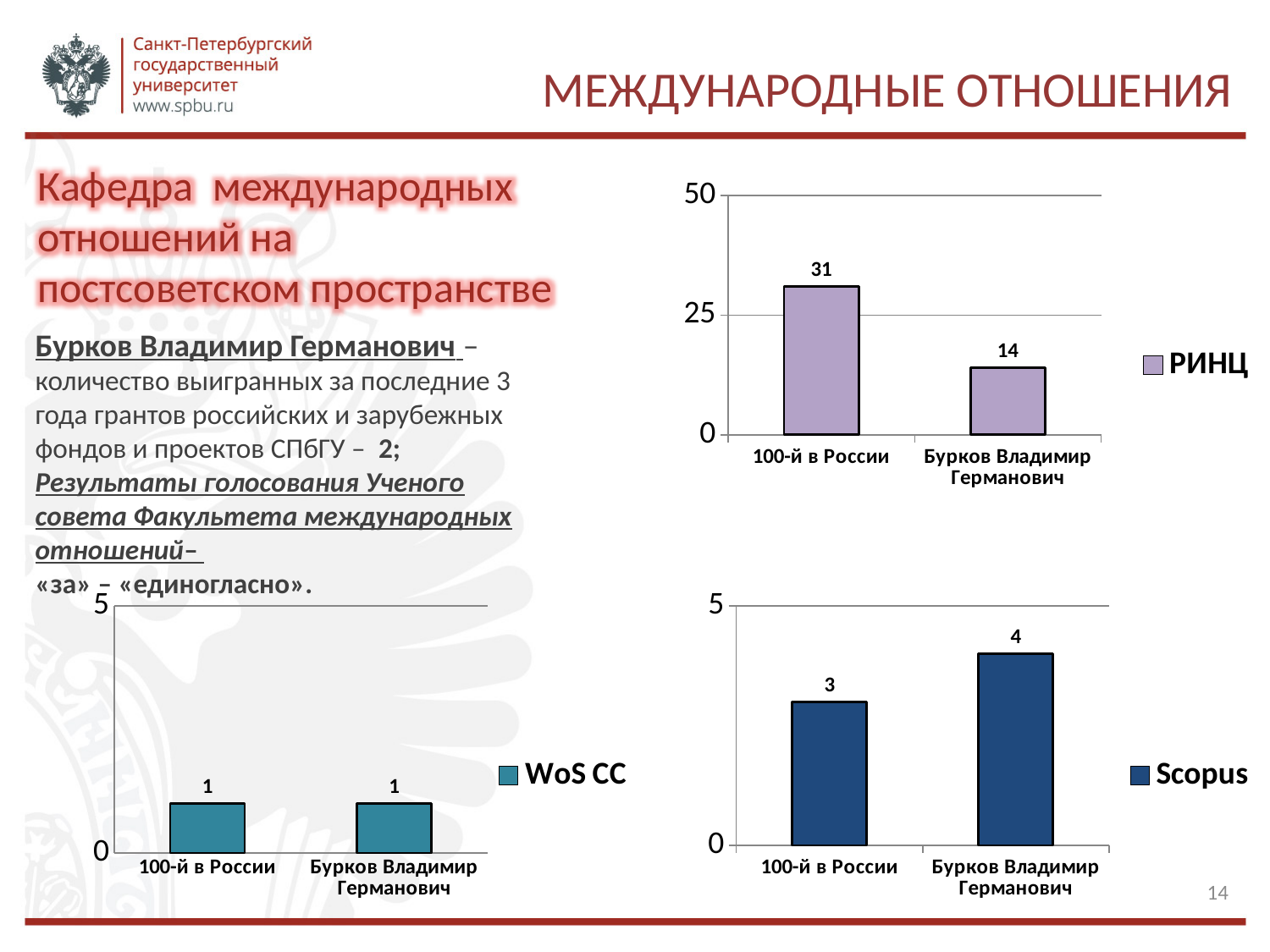
In the РИНЦ chart (top right), what is the value for Бурков Владимир Германович? 14 In the WoS CC chart (bottom left), what is the value for 100-й в России? 1 In the РИНЦ chart (top right), is the value for Бурков Владимир Германович greater or less than 25? less How many series does the legend of the РИНЦ chart (top right) list? 1 In the WoS CC chart (bottom left), how many categories are shown on the x axis? 2 In the Scopus chart (bottom right), what is the value for Бурков Владимир Германович? 4 In the РИНЦ chart (top right), which category has the higher value? 100-й в России In the Scopus chart (bottom right), what is the value for 100-й в России? 3 In the Scopus chart (bottom right), which category has the lower value? 100-й в России What kind of chart is the Scopus chart (bottom right)? bar chart In the РИНЦ chart (top right), what is the value for 100-й в России? 31 In the РИНЦ chart (top right), what is the difference between the value for 100-й в России and the value for Бурков Владимир Германович? 17